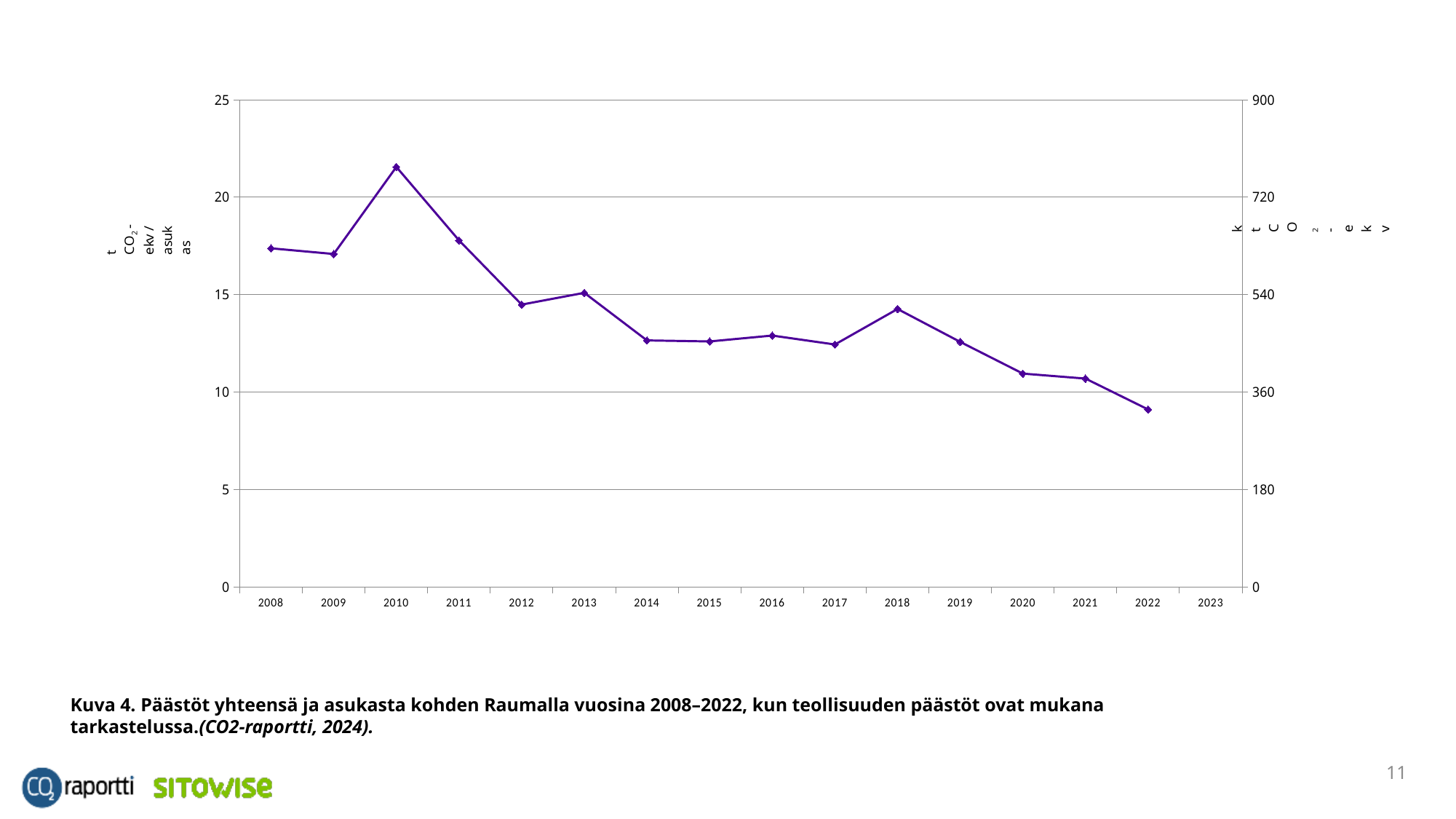
Which is larger, the value for 2010 or the value for 2011? 2010 How many years have a plotted data point on the line? 15 Is the value for 2022 greater or less than 10 on the left axis? less Is the value for 2008 greater or less than 15 on the left axis? greater Overall, do the values rise or fall from 2008 to 2022? fall Is the value for 2010 greater or less than 20 on the left axis? greater Which is larger, the value for 2017 or the value for 2018? 2018 What kind of chart is shown on the slide? line chart Which year has the lowest value on the line? 2022 Which year has the highest value on the line? 2010 What is the highest tick value shown on the right-hand axis? 900